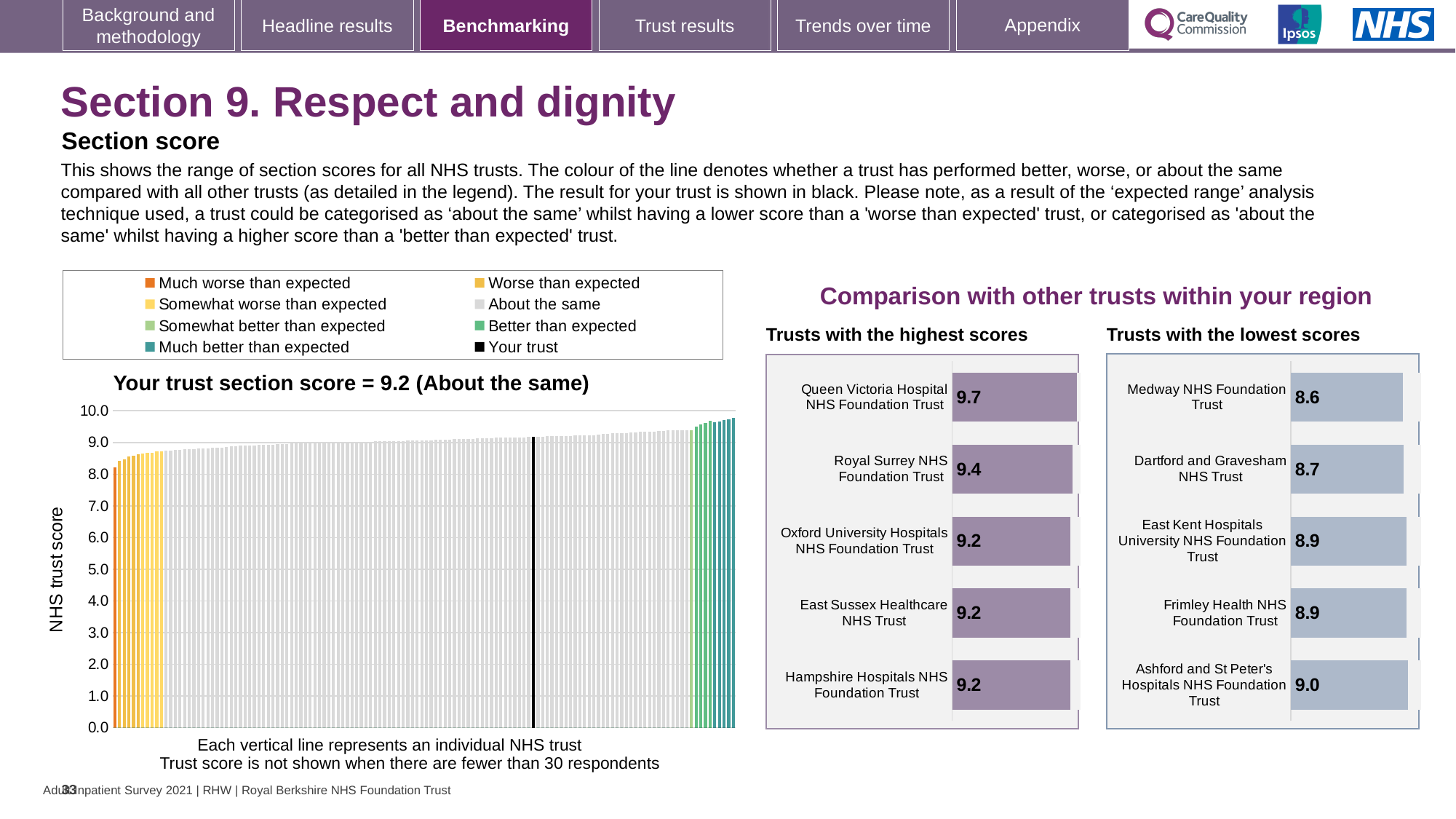
In the 'Trusts with the lowest scores' chart, which trust has the lowest score? Medway NHS Foundation Trust In the 'Trusts with the lowest scores' chart, what is the score for Medway NHS Foundation Trust? 8.6 In the 'Trusts with the highest scores' chart, which trust has the highest score? Queen Victoria Hospital NHS Foundation Trust In the 'Trusts with the lowest scores' chart, how many trusts are listed? 5 In the 'Your trust section score' chart, is the value of the leftmost bar greater or less than 7.0? greater In the 'Trusts with the highest scores' chart, what is the score for Queen Victoria Hospital NHS Foundation Trust? 9.7 In the 'Trusts with the highest scores' chart, what is the difference between the scores of Queen Victoria Hospital NHS Foundation Trust and Royal Surrey NHS Foundation Trust? 0.3 In the 'Trusts with the highest scores' chart, what is the score for Royal Surrey NHS Foundation Trust? 9.4 In the 'Your trust section score' chart, do the bar values rise or fall from left to right? rise In the 'Trusts with the lowest scores' chart, which has the larger score: Dartford and Gravesham NHS Trust or Medway NHS Foundation Trust? Dartford and Gravesham NHS Trust How many entries does the legend above the 'Your trust section score' chart list? 8 In the 'Your trust section score' chart, what is the section score for your trust? 9.2